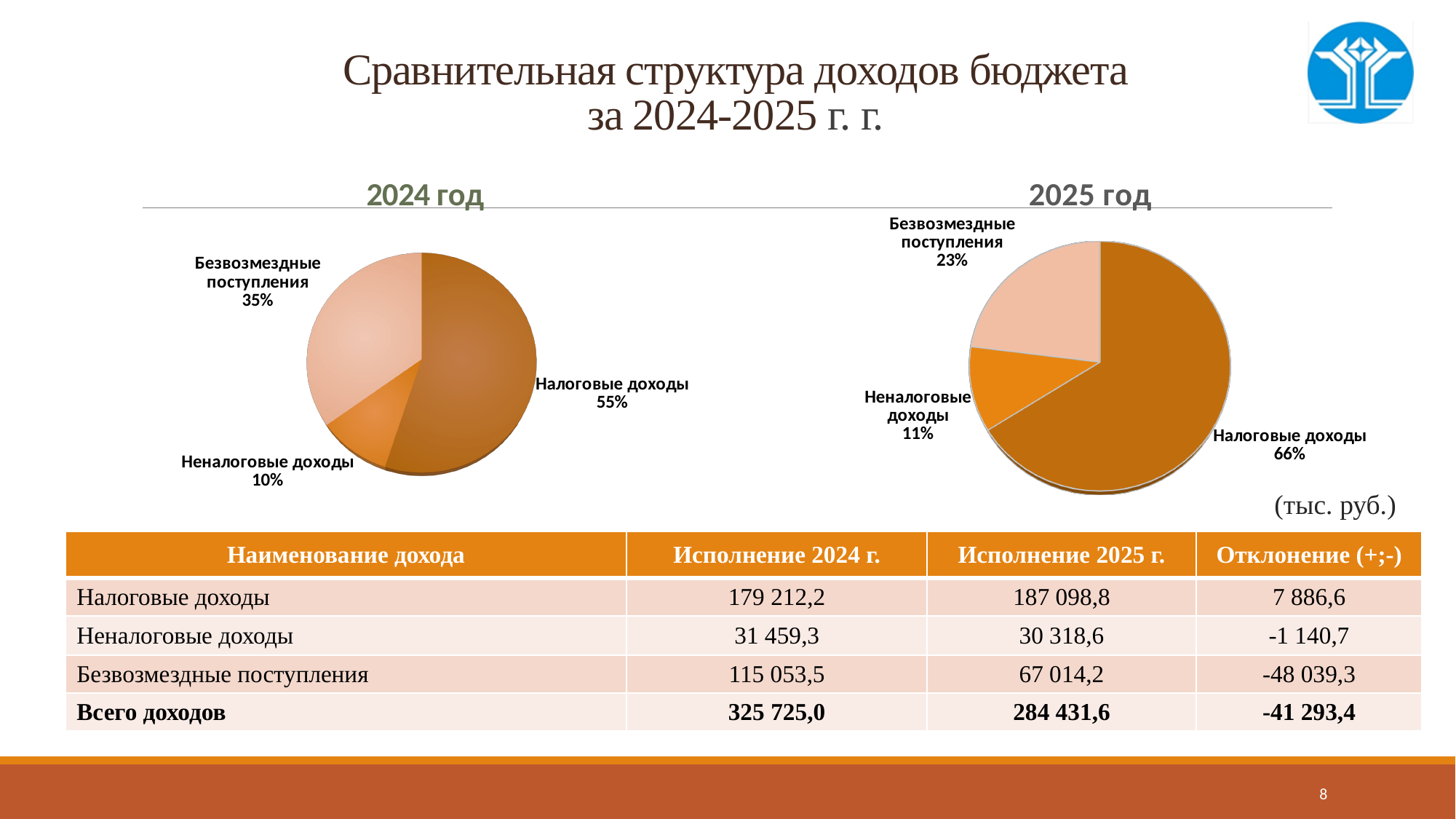
In the "2025 год" chart, what is the difference in percentage points between "Налоговые доходы" and "Безвозмездные поступления"? 43 In the "2025 год" chart, which category has the smallest slice? Неналоговые доходы What type of chart is the "2025 год" chart? Pie chart How many slices does the "2024 год" chart have? 3 In the "2025 год" chart, what share of the pie is "Неналоговые доходы"? 11% Which is larger: the share of "Безвозмездные поступления" in the "2024 год" chart or in the "2025 год" chart? 2024 год In the "2024 год" chart, what share of the pie is "Налоговые доходы"? 55% In the "2024 год" chart, which category has the largest slice? Налоговые доходы In the "2025 год" chart, what share of the pie is "Безвозмездные поступления"? 23%